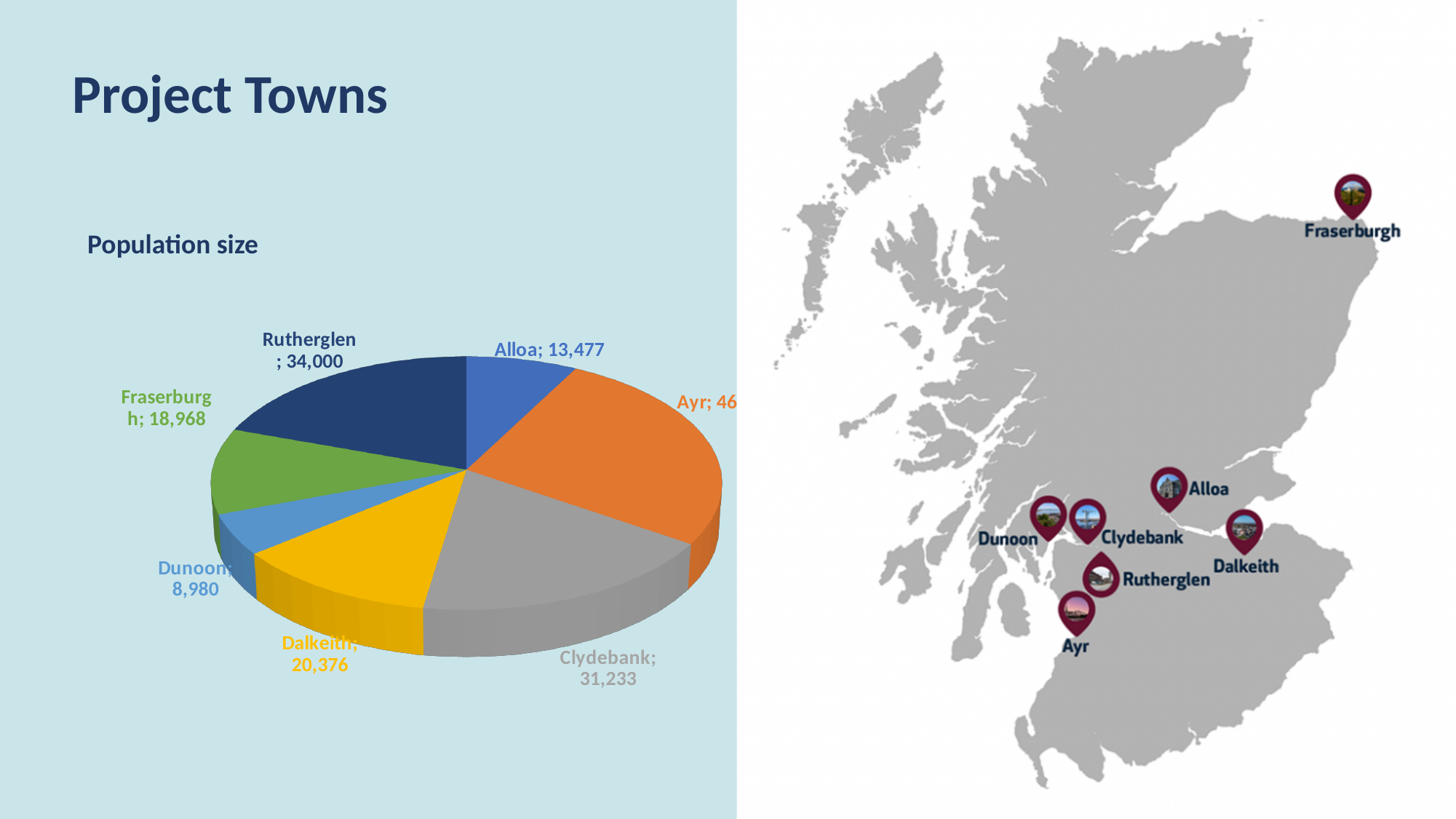
What is the population size shown for Dunoon? 8,980 What is the population size shown for Clydebank? 31,233 What is the population size shown for Dalkeith? 20,376 Which town has the largest slice in the pie chart? Ayr What kind of chart is shown under the heading "Population size"? Pie chart What is the population size shown for Alloa? 13,477 Which has the larger population size, Dalkeith or Fraserburgh? Dalkeith What is the difference between the population sizes of Rutherglen and Clydebank? 2,767 Which town has the smallest slice in the pie chart? Dunoon How many towns are shown in the pie chart? 7 What is the population size shown for Rutherglen? 34,000 What is the population size shown for Fraserburgh? 18,968